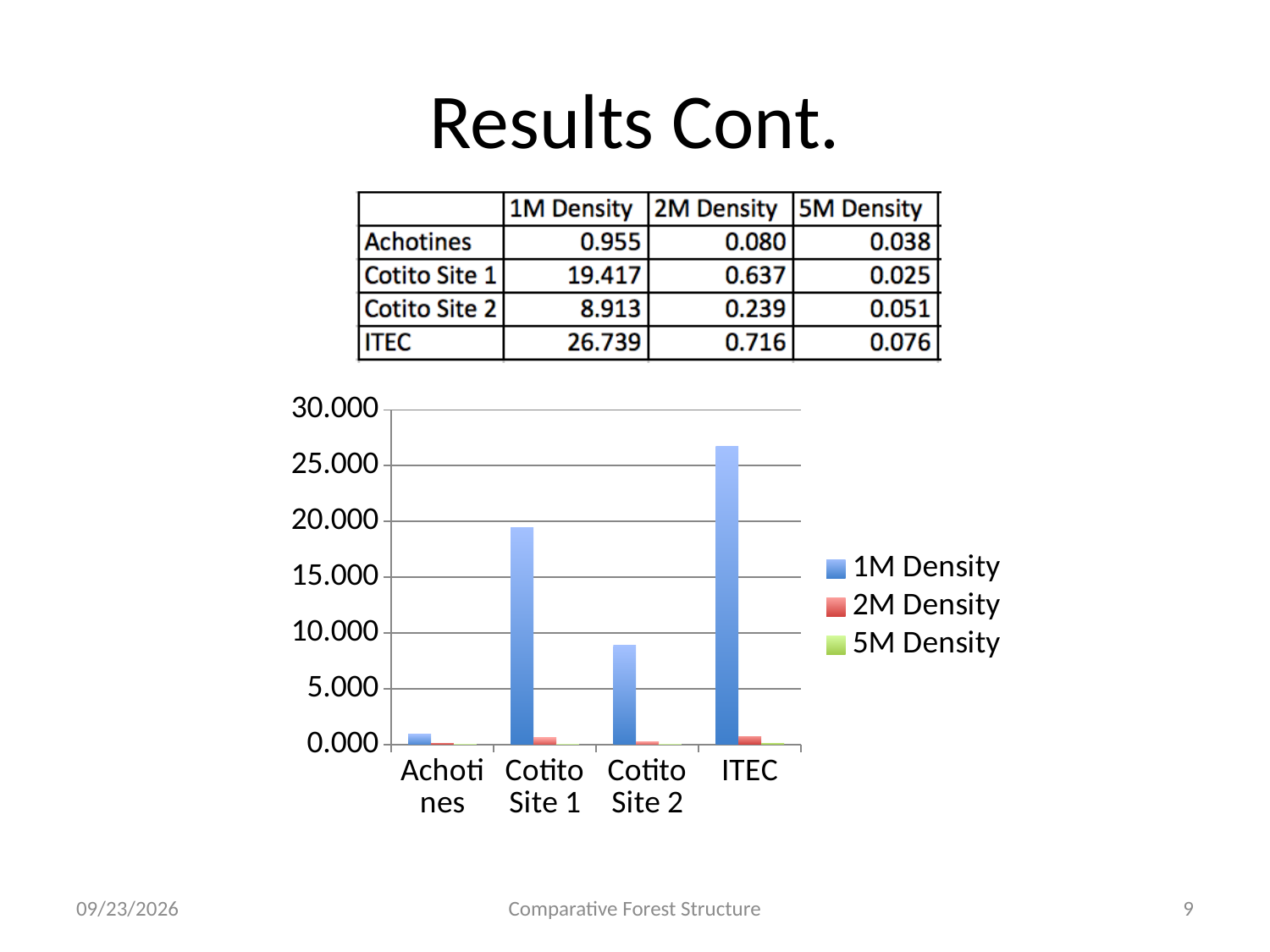
What is the 1M Density value for ITEC? 26.739 Is the 1M Density for ITEC greater or less than 25.000? greater Which site has the lowest 1M Density? Achotines What is the 2M Density value for Cotito Site 2? 0.239 What kind of chart is shown on the slide? bar chart What is the 1M Density value for Cotito Site 1? 19.417 Which site has the highest 1M Density? ITEC Which is larger, the 1M Density for Cotito Site 1 or for Cotito Site 2? Cotito Site 1 What is the difference between the 1M Density of ITEC and Cotito Site 1? 7.322 How many site categories are shown on the x axis of the chart? 4 Is the 1M Density for Cotito Site 2 greater or less than 10.000? less How many series does the chart legend list? 3